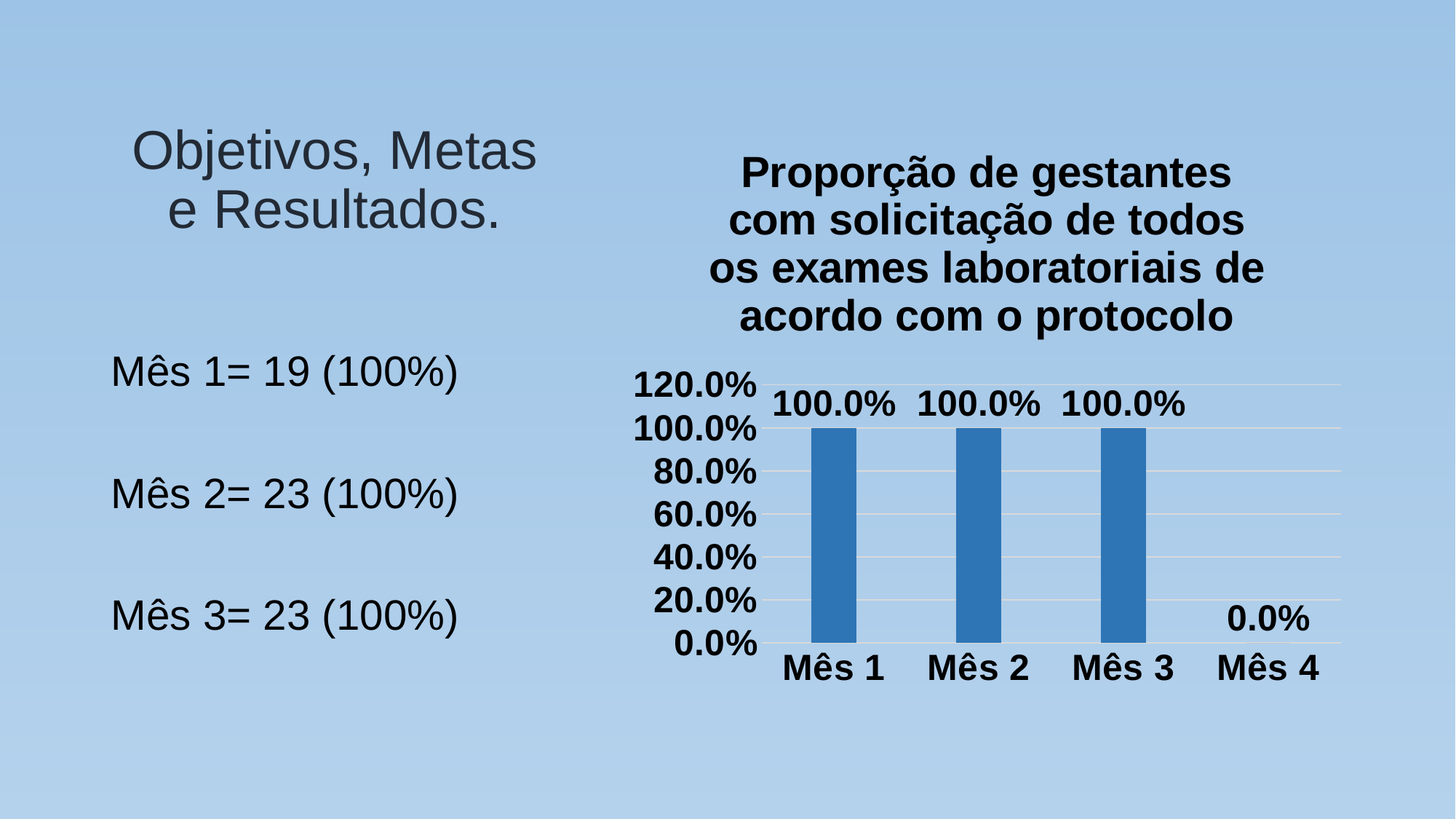
What is the value for Mês 3? 100.0% Which category has the lowest value? Mês 4 What is the highest tick value shown on the y axis? 120.0% What is the value for Mês 4? 0.0% Is the value for Mês 2 greater or less than 80.0%? greater Which is larger, the value for Mês 3 or the value for Mês 4? Mês 3 How many categories are shown on the x axis? 4 What is the value for Mês 1? 100.0% What is the difference between the values for Mês 2 and Mês 4? 100.0% How many categories have a value of 100.0%? 3 What kind of chart is shown on the slide? bar chart What is the title of the chart? Proporção de gestantes com solicitação de todos os exames laboratoriais de acordo com o protocolo